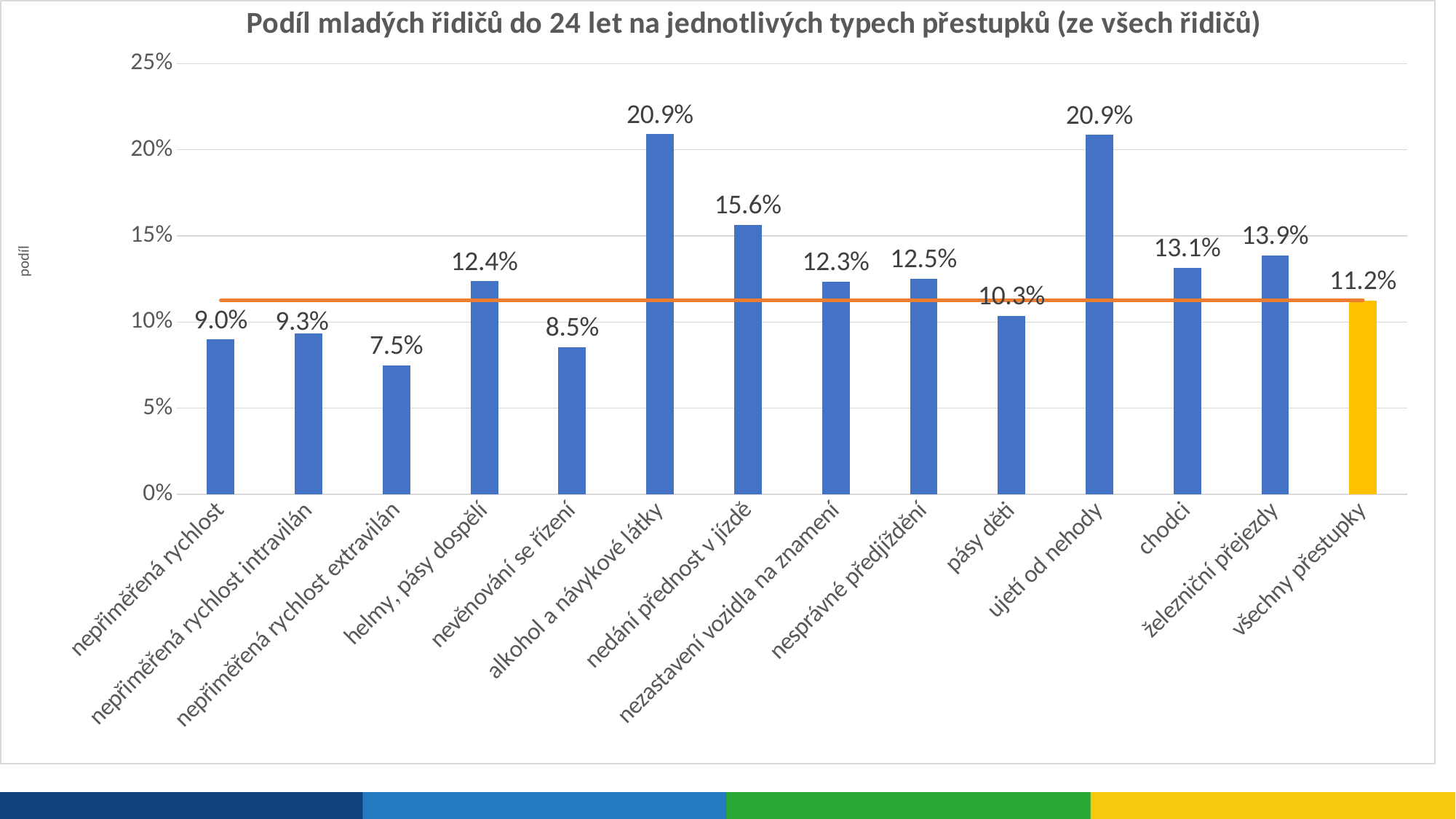
What is the value for 'všechny přestupky'? 11.2% Which category has the lowest value? nepřiměřená rychlost extravilán What is the value for 'nedání přednost v jízdě'? 15.6% What is the value for 'pásy děti'? 10.3% What is the difference between the values for 'železniční přejezdy' and 'chodci'? 0.8% Which bar is coloured differently (yellow) from the others? všechny přestupky What kind of chart is this? combination bar and line chart How many categories are shown on the x axis? 14 What is the value for 'alkohol a návykové látky'? 20.9% Is the value for 'ujetí od nehody' greater or less than 20%? greater What is the title of the chart? Podíl mladých řidičů do 24 let na jednotlivých typech přestupků (ze všech řidičů) Which is larger, the value for 'helmy, pásy dospělí' or the value for 'nevěnování se řízení'? helmy, pásy dospělí